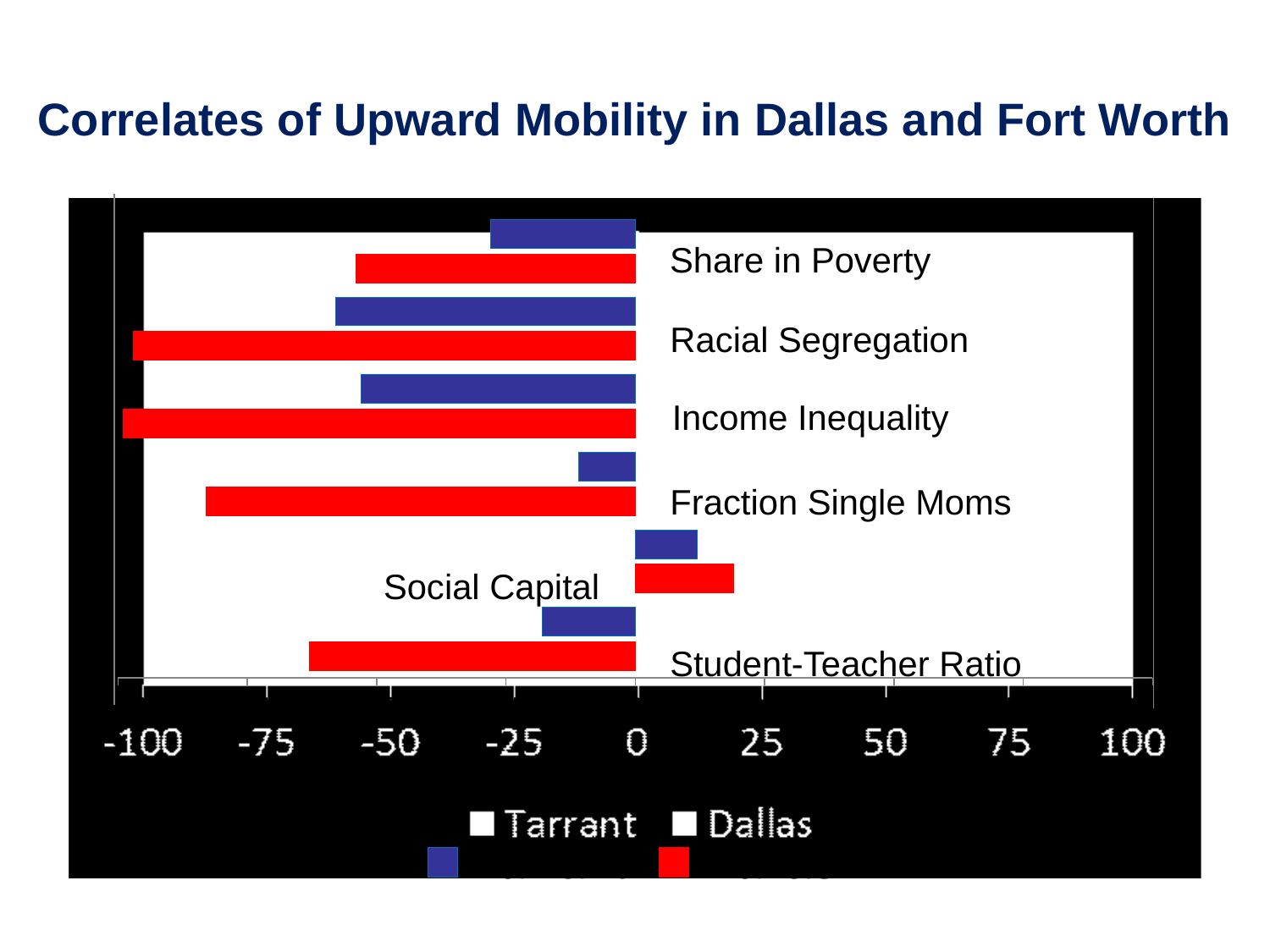
What colour are the Dallas bars in the chart? red How many categories are plotted in the chart? 6 How many series does the legend list? 2 What kind of chart is shown on the slide? bar chart Is the Tarrant value for Share in Poverty greater or less than -50? greater Which category has the highest Dallas value? Social Capital For Social Capital, which series has the larger value, Tarrant or Dallas? Dallas For Share in Poverty, which series has the higher value, Tarrant or Dallas? Tarrant Is the Tarrant value for Fraction Single Moms greater or less than -25? greater Which category has the highest Tarrant value? Social Capital Is the Dallas value for Racial Segregation greater or less than -75? less